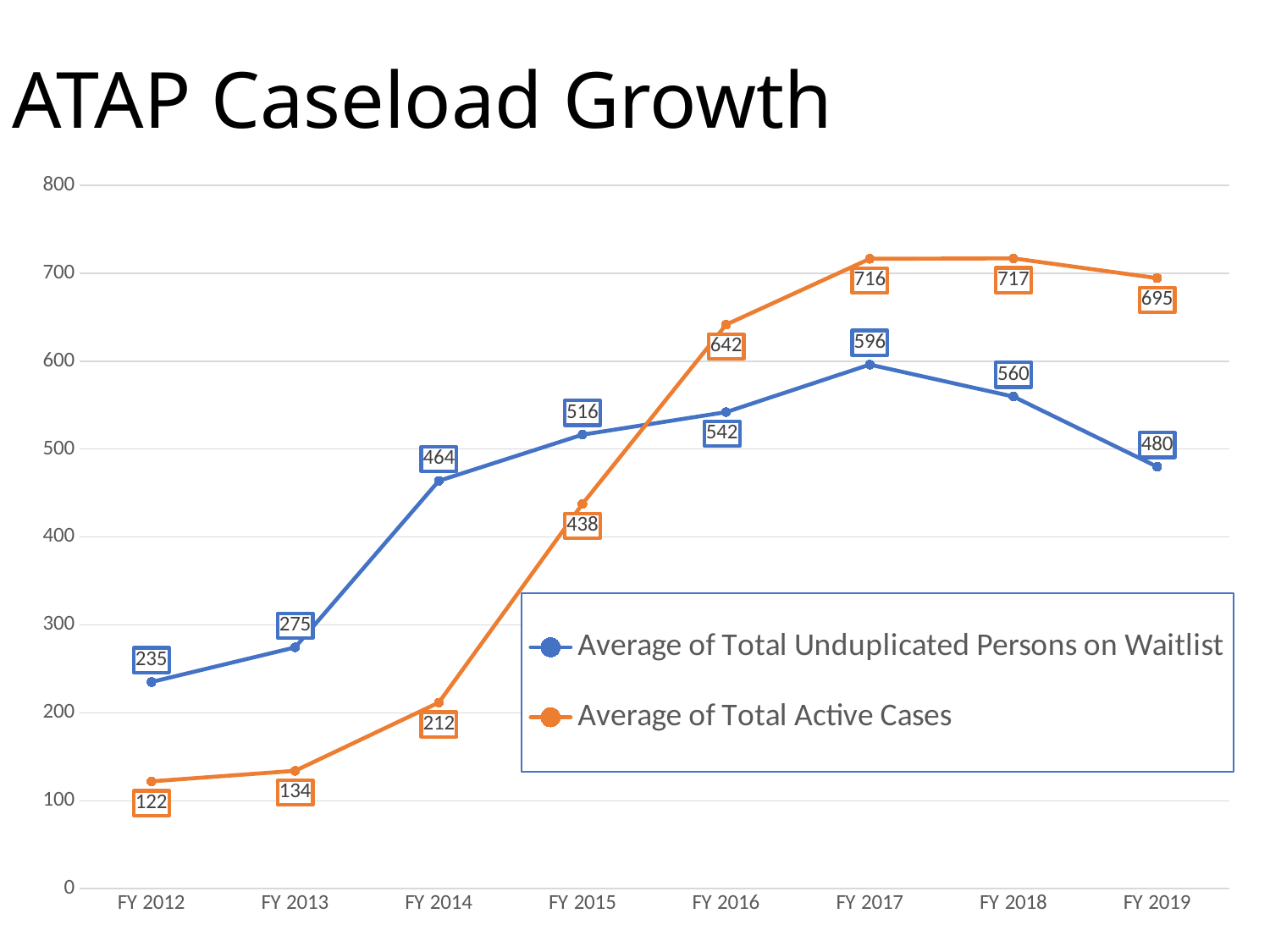
In which fiscal year is the Average of Total Active Cases lowest? FY 2012 What is the difference between the Average of Total Active Cases and the Average of Total Unduplicated Persons on Waitlist in FY 2019? 215 What is the Average of Total Unduplicated Persons on Waitlist for FY 2014? 464 What is the title of the slide? ATAP Caseload Growth What is the Average of Total Active Cases for FY 2015? 438 Does the Average of Total Active Cases rise or fall from FY 2012 to FY 2017? rise Which is larger in FY 2014: the Average of Total Unduplicated Persons on Waitlist or the Average of Total Active Cases? Average of Total Unduplicated Persons on Waitlist Is the Average of Total Active Cases for FY 2016 greater or less than 600? greater How many series does the legend list? 2 How many fiscal years are shown on the x axis? 8 What kind of chart is shown on the slide? line chart In which fiscal year is the Average of Total Unduplicated Persons on Waitlist highest? FY 2017